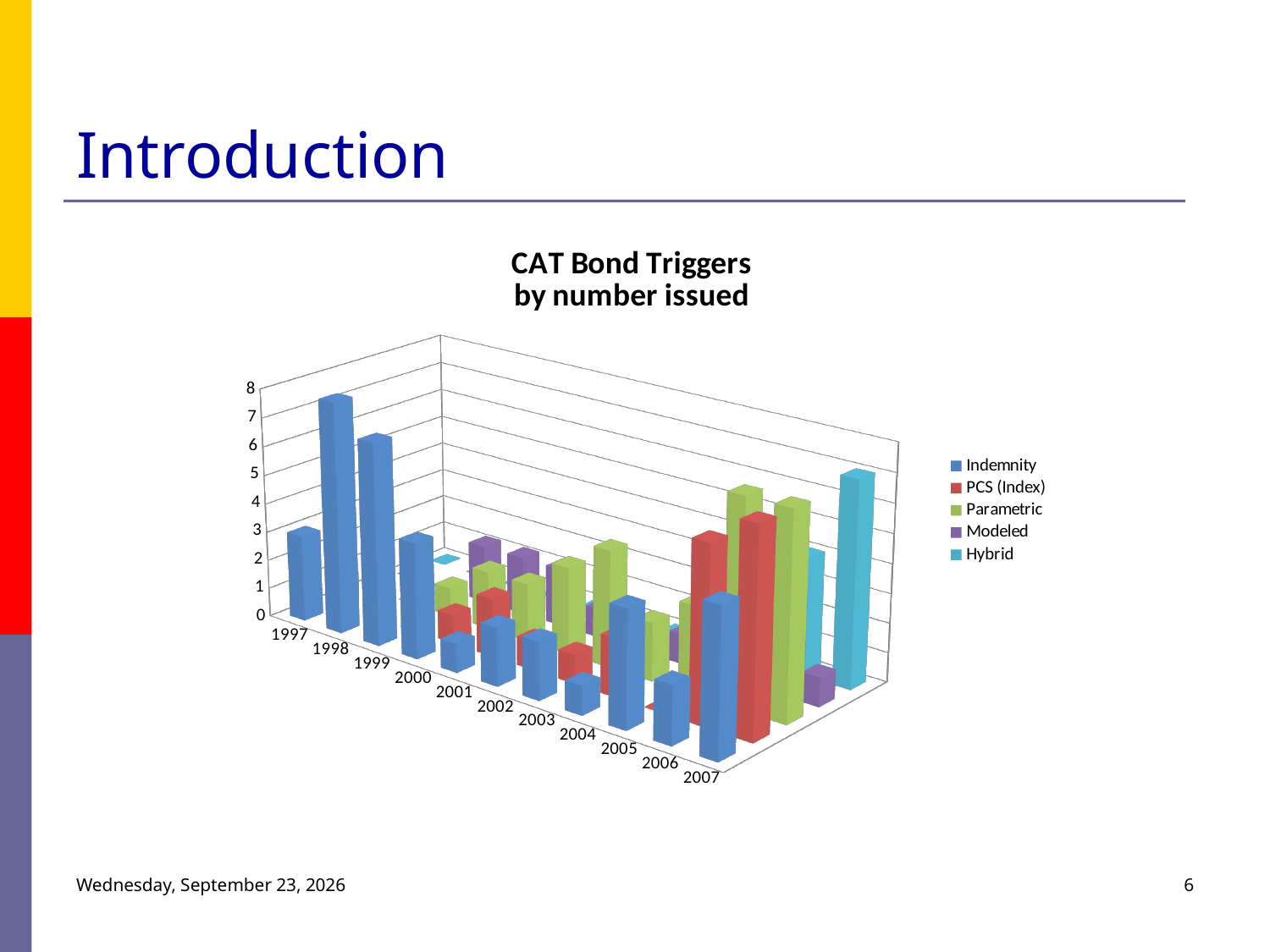
Which series is shown in red in the legend? PCS (Index) How many series does the legend list? 5 Is the Indemnity value for 1998 greater or less than 4? greater What is the title of the chart? CAT Bond Triggers by number issued In which year is the Indemnity bar the tallest? 1998 Is the Indemnity value for 1997 greater or less than 5? less Does the Indemnity value rise or fall from 1998 to 1999? fall Is the Hybrid value for 2007 greater or less than 2? greater Which is larger, the Indemnity value for 1998 or the Indemnity value for 1999? 1998 Which is larger, the Indemnity value for 1997 or the Indemnity value for 1998? 1998 How many years are shown along the x axis? 11 What kind of chart is shown on the slide? bar chart